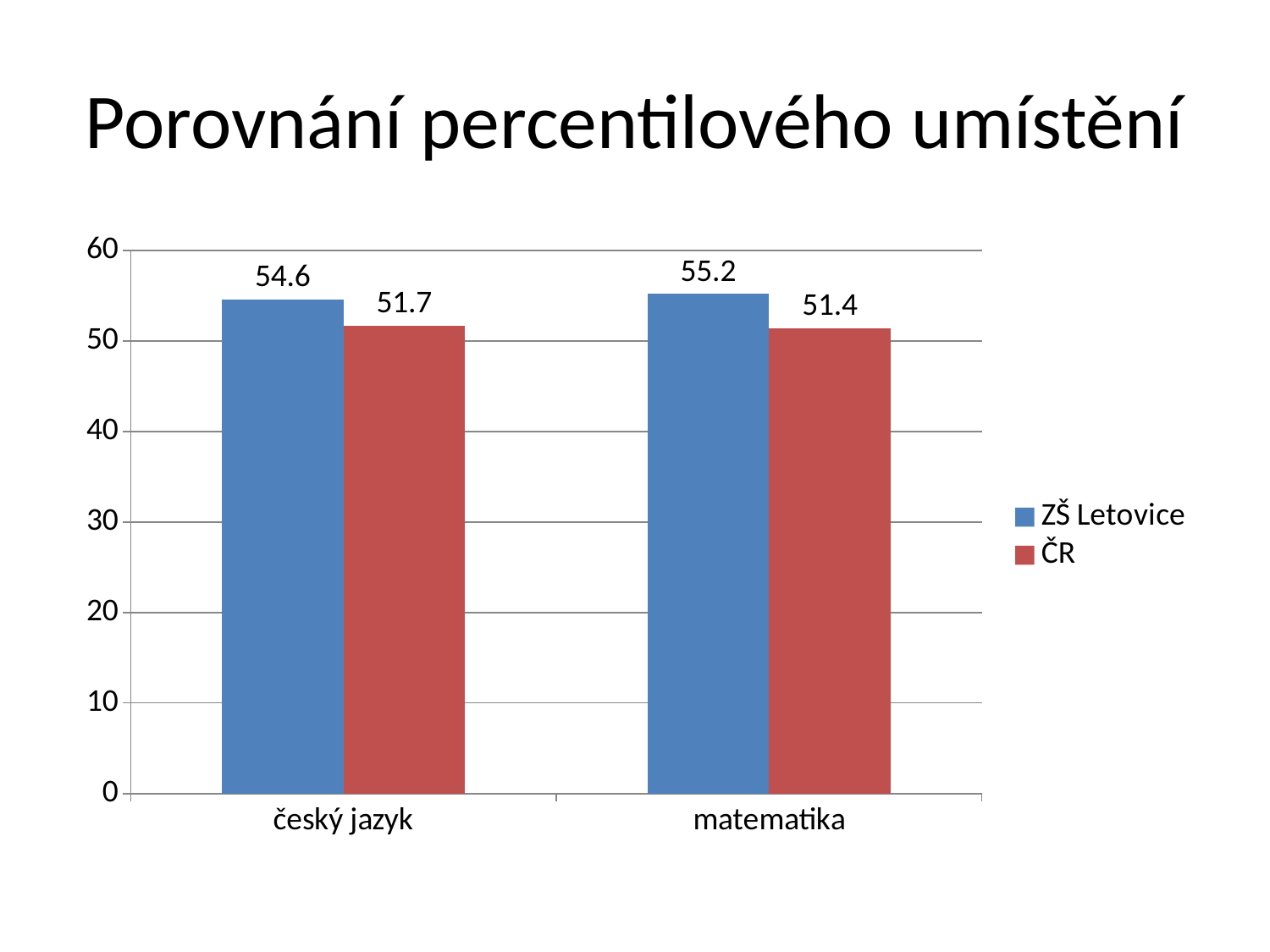
What is the value for ZŠ Letovice in český jazyk? 54.6 What is the difference between ZŠ Letovice and ČR in matematika? 3.8 What is the value for ZŠ Letovice in matematika? 55.2 Which is larger in český jazyk, ZŠ Letovice or ČR? ZŠ Letovice How many series does the legend list? 2 What is the difference between ZŠ Letovice and ČR in český jazyk? 2.9 Which category has the highest value for ZŠ Letovice? matematika How many categories are shown on the x axis? 2 Which category has the lowest value for ČR? matematika What kind of chart is shown on the slide? bar chart What is the value for ČR in matematika? 51.4 What is the value for ČR in český jazyk? 51.7